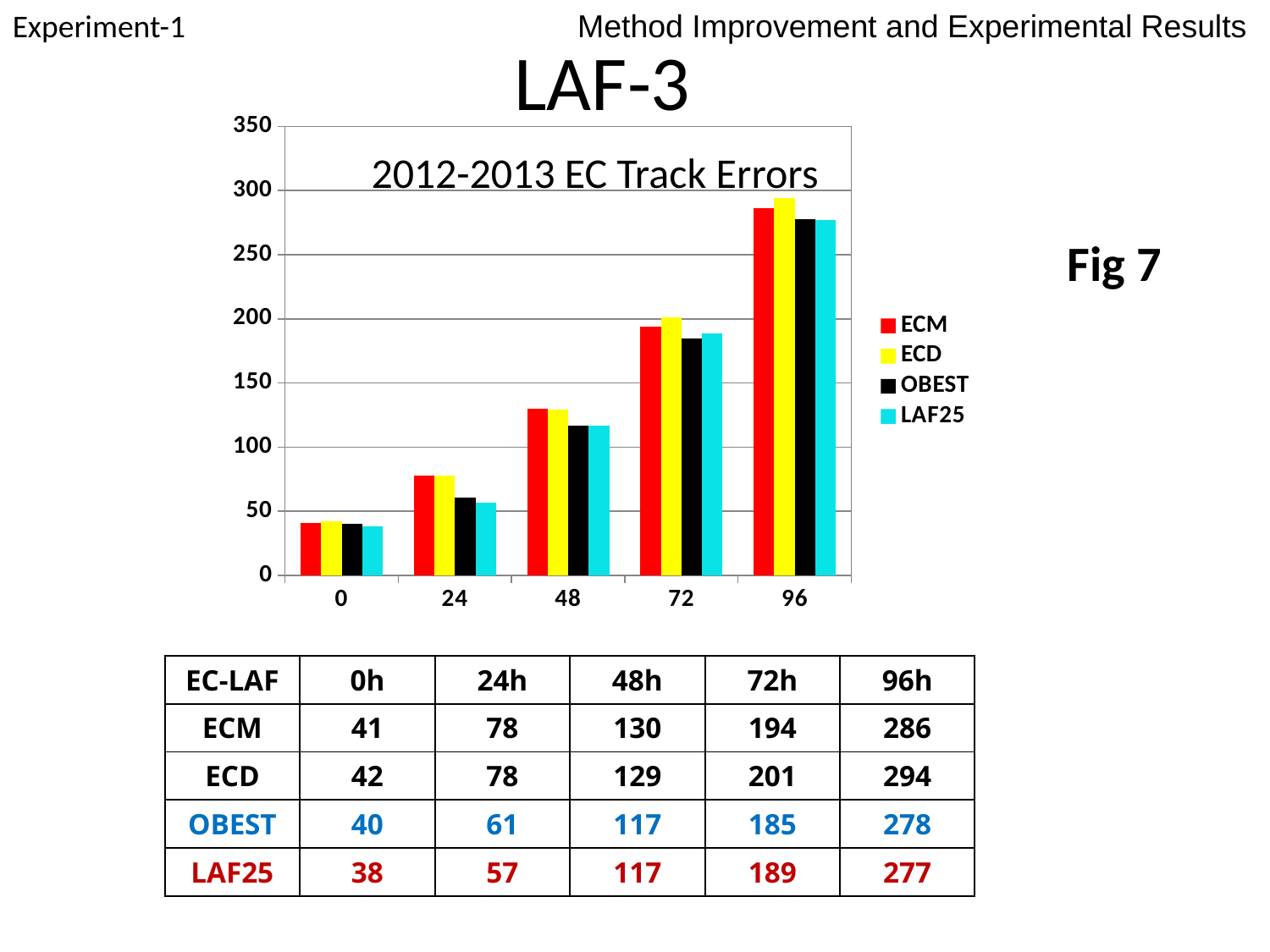
What is the ECM value at 96h? 286 What is the OBEST value at 72h? 185 How many categories are shown along the x axis of the chart? 5 What is the title of the chart? 2012-2013 EC Track Errors Is the ECM value at 72h greater or less than 150? greater Do the ECM values rise or fall as the forecast hour increases from 0 to 96? rise Which series has the highest value at 96h? ECD What kind of chart is shown on the slide? bar chart Which series has the lowest value at 24h? LAF25 What is the LAF25 value at 24h? 57 How many series does the chart legend list? 4 What is the difference between the ECD and LAF25 values at 96h? 17